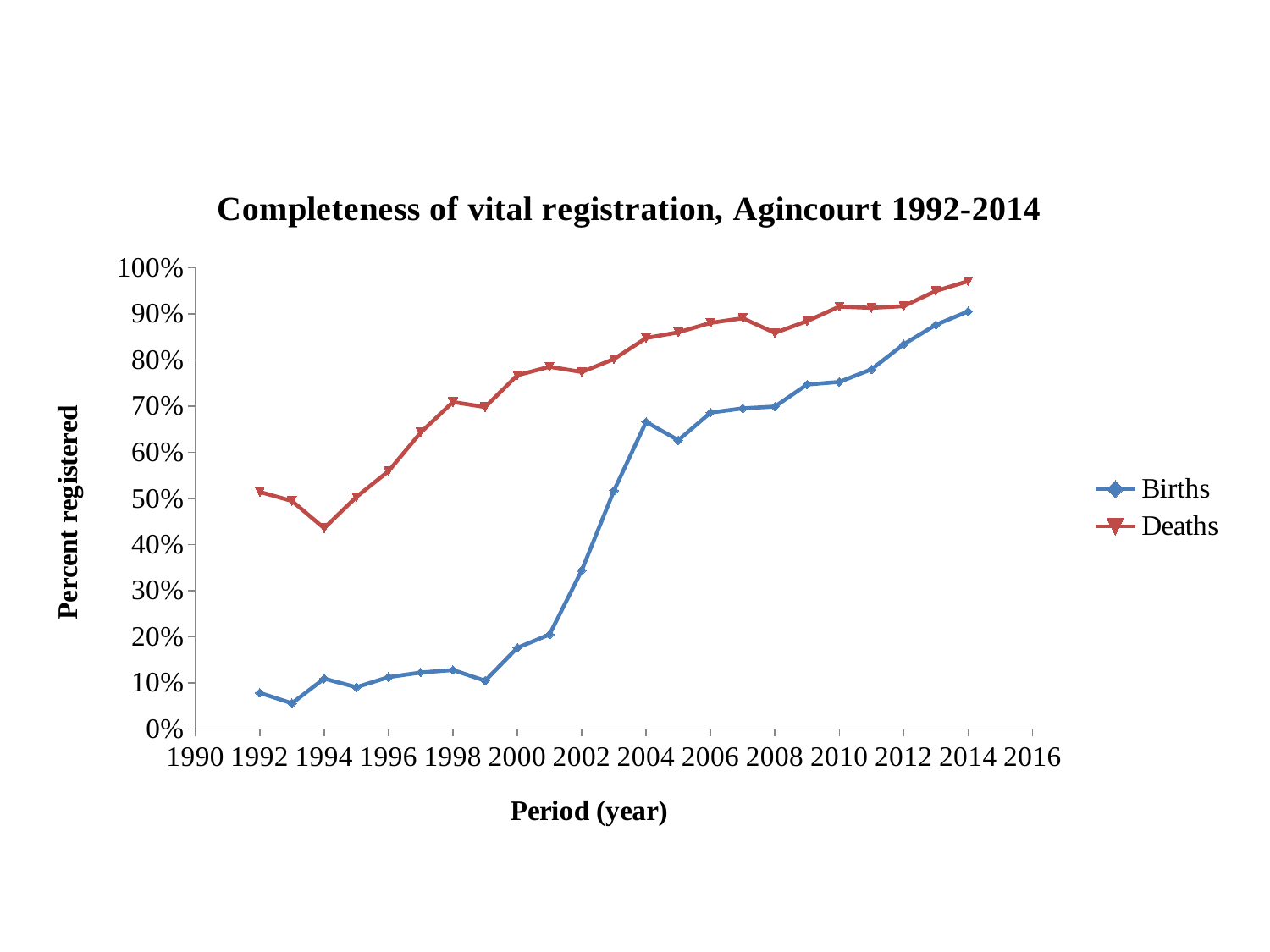
In which year is the Deaths series at its lowest? 1994 Is the value for Deaths in 2014 greater or less than 90%? greater What is the title of the chart? Completeness of vital registration, Agincourt 1992-2014 Is the value for Births in 2004 greater or less than 60%? greater Is the value for Deaths in 2000 greater or less than 70%? greater Which series has the higher value in 2000, Births or Deaths? Deaths How many series does the legend list? 2 What kind of chart is shown on the slide? Line chart In which year is the Births series at its highest? 2014 What is the label of the y axis? Percent registered Overall, do the Births values rise or fall from 1992 to 2014? Rise